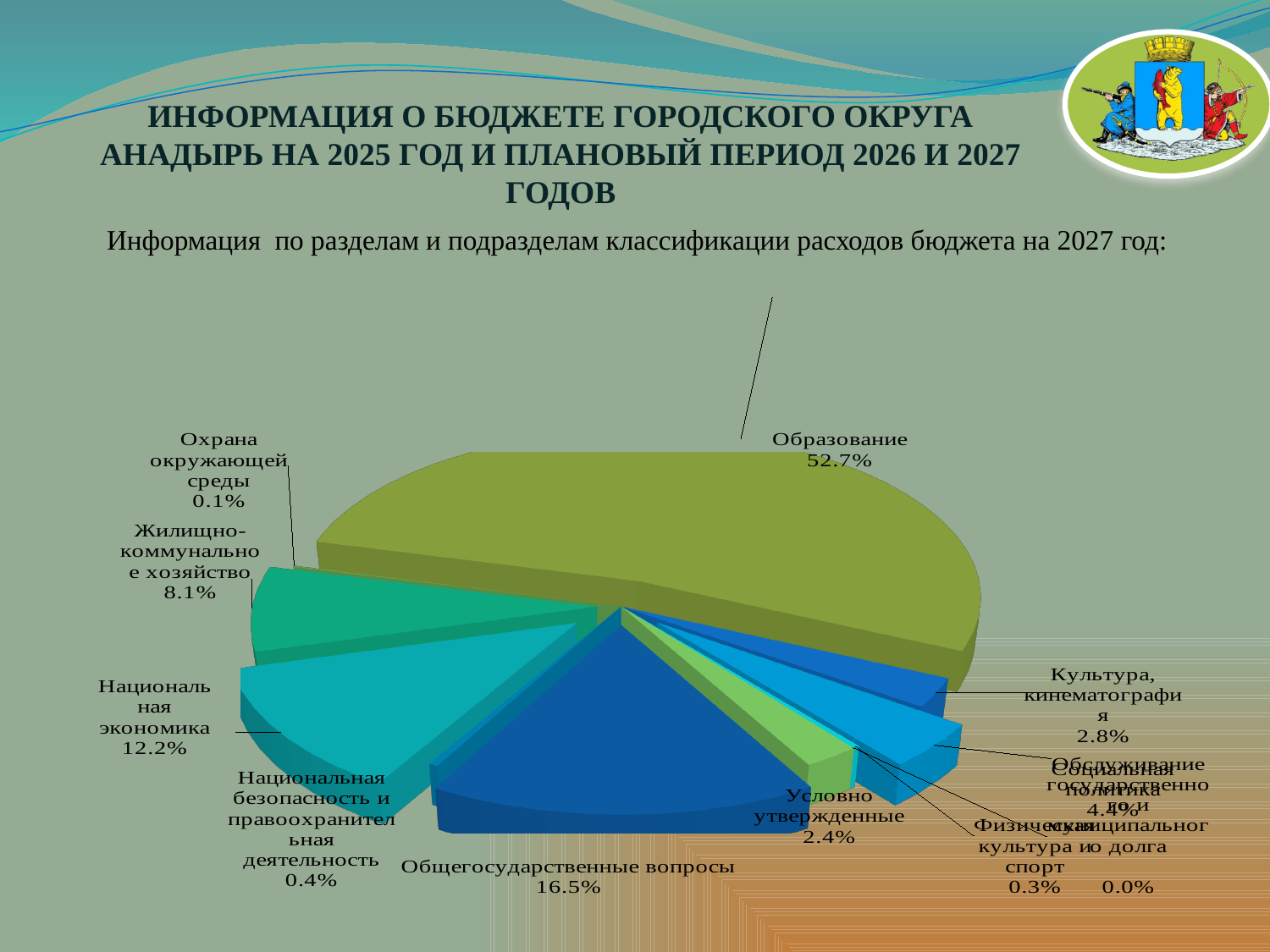
Which category has the largest share of the pie? Образование Which is larger: the share for Национальная экономика or for Жилищно-коммунальное хозяйство? Национальная экономика What percentage is shown for Национальная экономика? 12.2% What is the difference in percentage points between Национальная экономика and Жилищно-коммунальное хозяйство? 4.1% What share of the 2027 budget expenditures goes to Образование? 52.7% What percentage is shown for Культура, кинематография? 2.8% What percentage is shown for Жилищно-коммунальное хозяйство? 8.1% For which year does the chart show the breakdown of budget expenditures by section? 2027 What kind of chart is shown on the slide? pie chart What is the difference in percentage points between Образование and Общегосударственные вопросы? 36.2% What percentage is shown for Общегосударственные вопросы? 16.5% What percentage is shown for Условно утвержденные? 2.4%